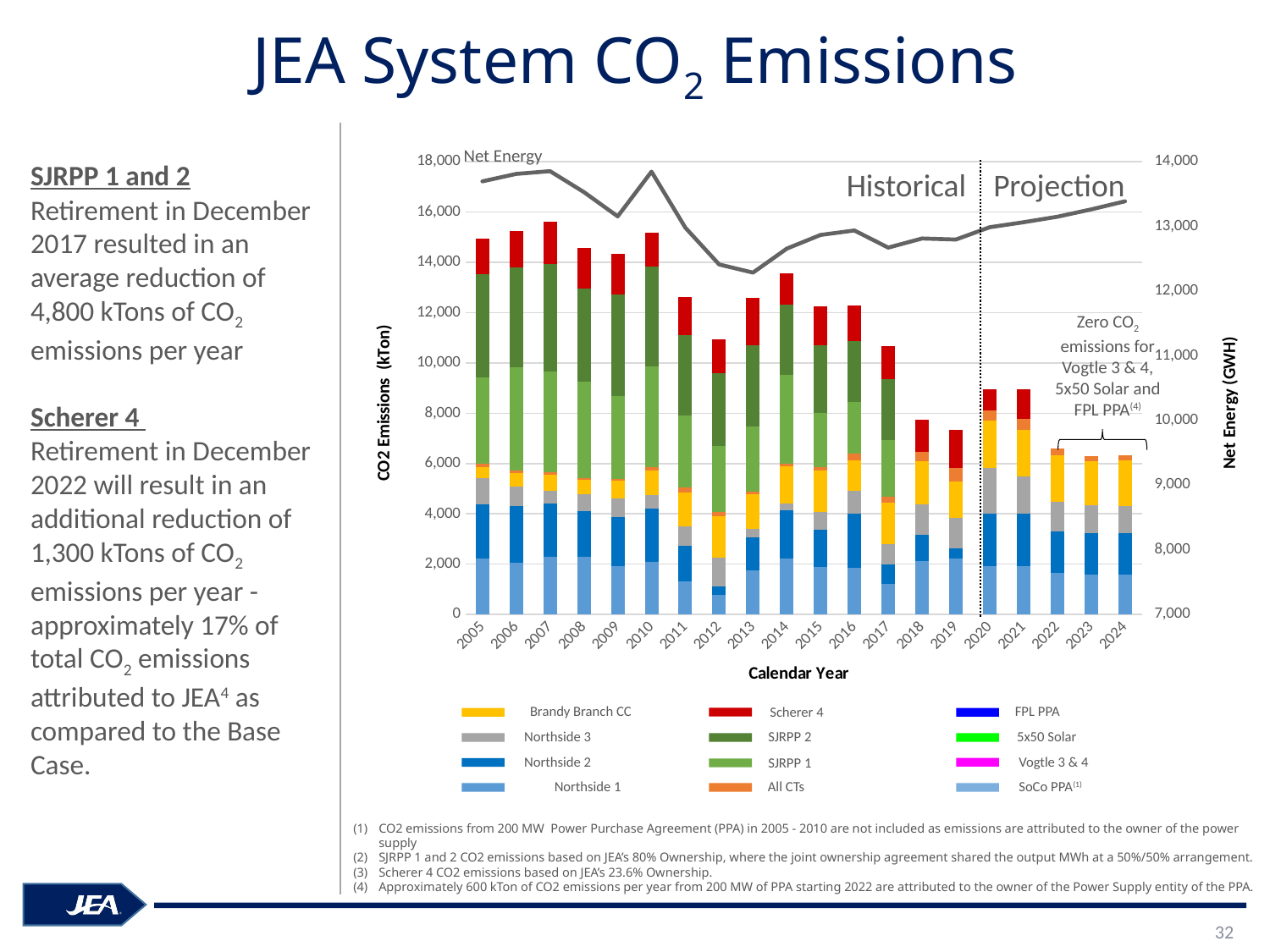
Is the total CO2 emissions bar for 2005 greater or less than 14,000 kTon? greater What is the title of the right-hand y axis of the chart? Net Energy (GWH) Is the total CO2 emissions bar for 2021 greater or less than 10,000 kTon? less Is the total CO2 emissions bar for 2024 greater or less than 8,000 kTon? less How many calendar years are shown on the x axis of the chart? 20 How many series does the chart's legend list? 12 What kind of chart is shown on the slide? combination bar and line chart Which calendar year has the highest total CO2 emissions bar? 2007 What is the title of the x axis of the chart? Calendar Year Which year has a taller total CO2 emissions bar, 2012 or 2013? 2013 Do the total CO2 emissions bars generally rise or fall from 2005 to 2024? fall